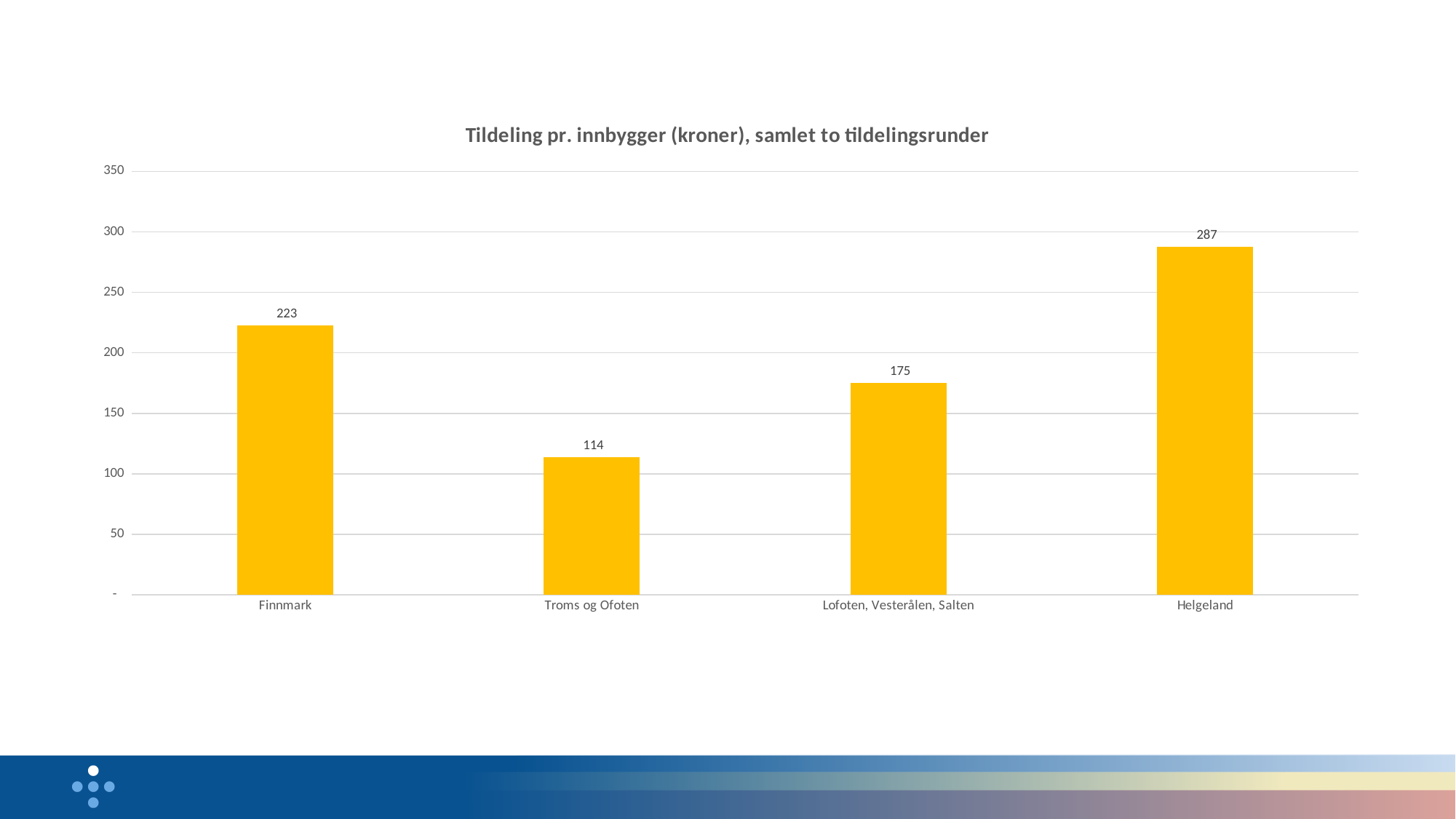
Is the value for Troms og Ofoten greater or less than 150? less What is the value for Helgeland? 287 Which region has the lowest value? Troms og Ofoten Which is larger, the value for Finnmark or the value for Lofoten, Vesterålen, Salten? Finnmark What is the value for Lofoten, Vesterålen, Salten? 175 What is the difference between the values for Helgeland and Finnmark? 64 What is the difference between the values for Lofoten, Vesterålen, Salten and Troms og Ofoten? 61 How many regions are shown in the chart? 4 What is the value for Finnmark? 223 What kind of chart is shown on the slide? bar chart Which region has the highest value? Helgeland What is the value for Troms og Ofoten? 114